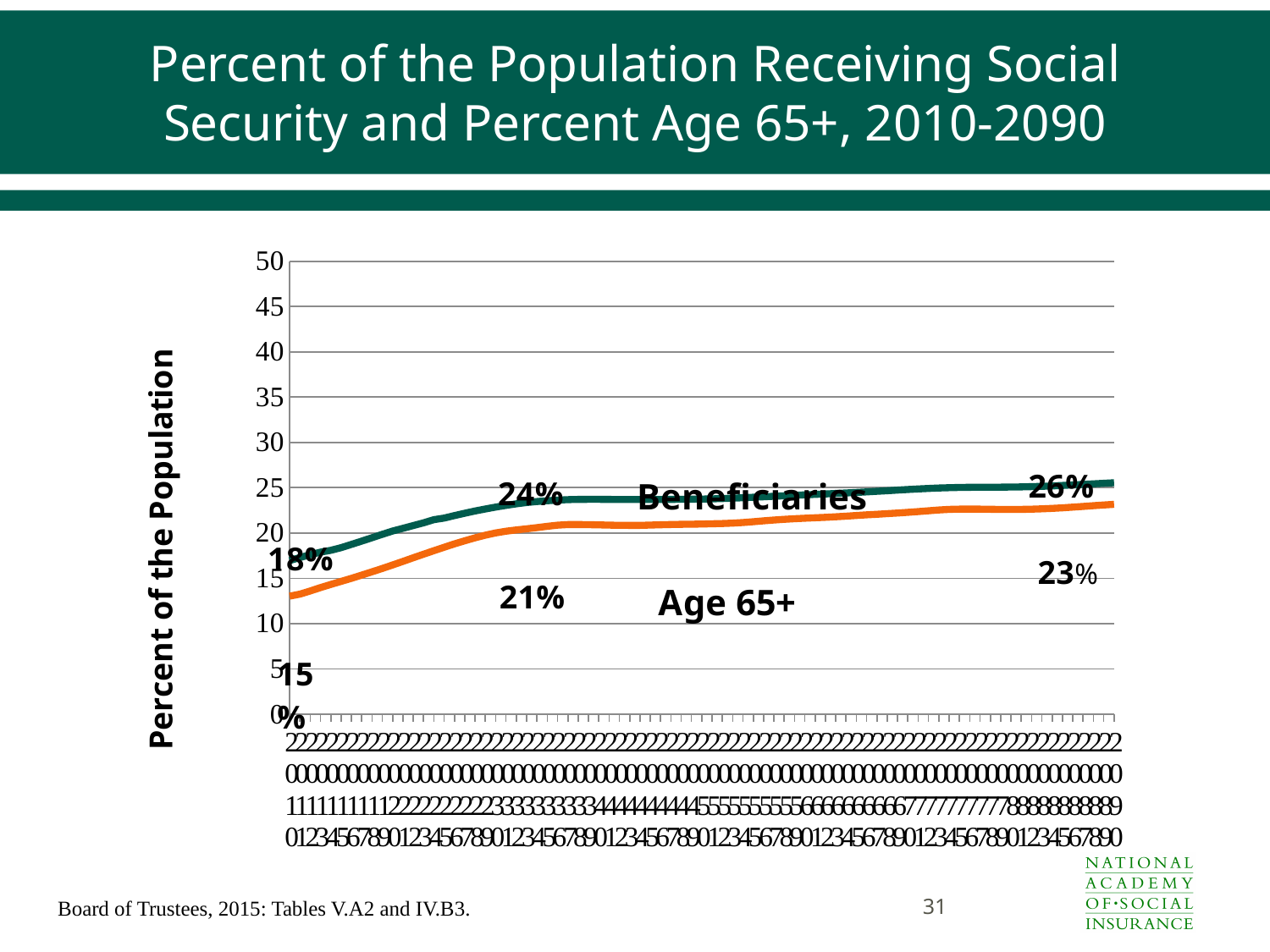
How many data series are plotted on the chart? 2 What is the labelled value for Beneficiaries at the start of the chart (2010)? 18% What is the labelled value for Beneficiaries at the end of the chart (2090)? 26% Does the Beneficiaries line generally rise or fall from 2010 to 2090? rise Is the Beneficiaries value at 2090 greater or less than 30? less By how many percentage points does Beneficiaries exceed Age 65+ at the end of the chart (2090)? 3 By how many percentage points does the Beneficiaries value rise from its first label (18%) to its last label (26%)? 8 Which series is higher at the end of the chart, Beneficiaries or Age 65+? Beneficiaries What type of chart is shown on the slide? line chart What is the title of the vertical axis? Percent of the Population What colour is the Beneficiaries line? green What is the labelled value for Age 65+ at the end of the chart (2090)? 23%